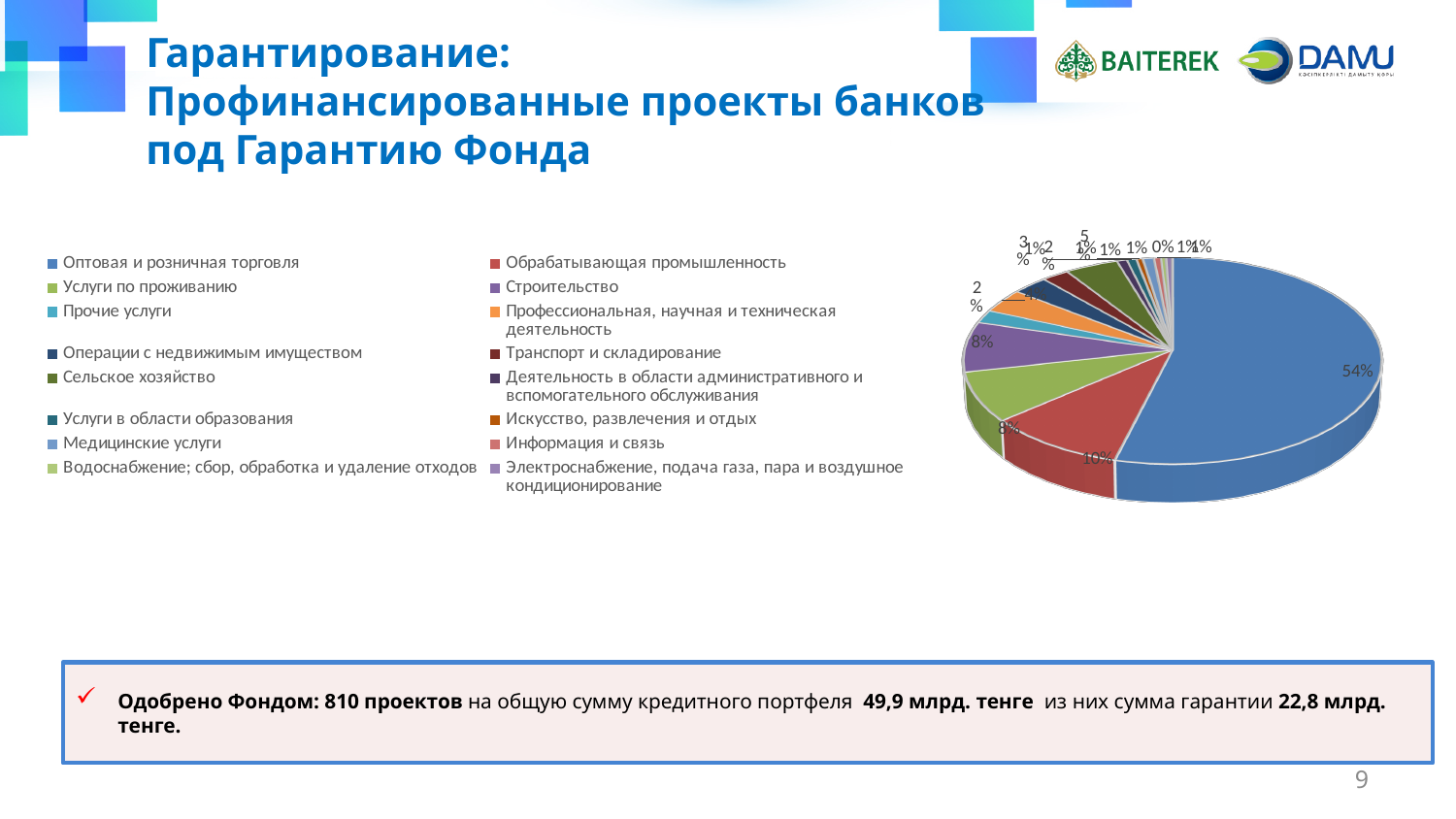
How many categories does the legend of the pie chart list? 16 What percentage is shown for Обрабатывающая промышленность? 10% By how many percentage points does Оптовая и розничная торговля exceed Обрабатывающая промышленность? 44 What share of the pie does Оптовая и розничная торговля hold? 54% What percentage is shown for Строительство? 8% Is the share for Оптовая и розничная торговля greater or less than 50%? greater Which is larger: the slice for Оптовая и розничная торговля or the slice for Обрабатывающая промышленность? Оптовая и розничная торговля What percentage is shown for Услуги по проживанию? 8% What is the smallest percentage label shown on the pie chart? 0% What kind of chart is shown on the slide? pie chart Which category has the largest slice in the pie chart? Оптовая и розничная торговля What is the title of the slide containing the pie chart? Гарантирование: Профинансированные проекты банков под Гарантию Фонда